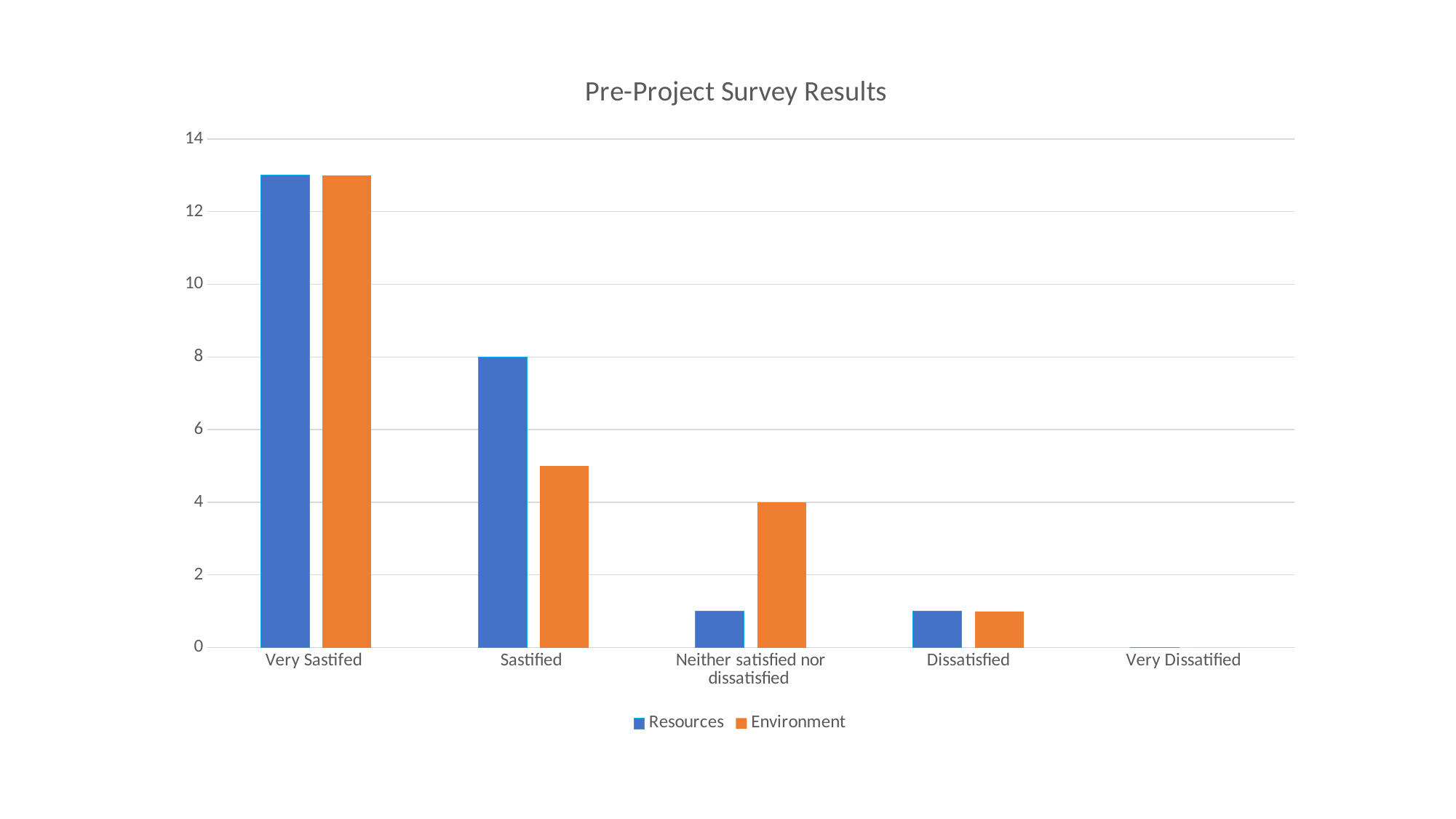
What is the title of the chart? Pre-Project Survey Results What is the Environment value for Neither satisfied nor dissatisfied? 4 Which category has the highest Environment value? Very Sastifed What kind of chart is shown on the slide? bar chart Is the Environment value for Sastified greater or less than 6? less Which category has the lowest Resources value? Very Dissatified What is the Resources value for Very Dissatified? 0 Is the Resources value for Very Sastifed greater or less than 12? greater For Sastified, which series has the larger value, Resources or Environment? Resources How many categories are shown on the x axis? 5 How many series does the legend list? 2 What is the Resources value for Sastified? 8